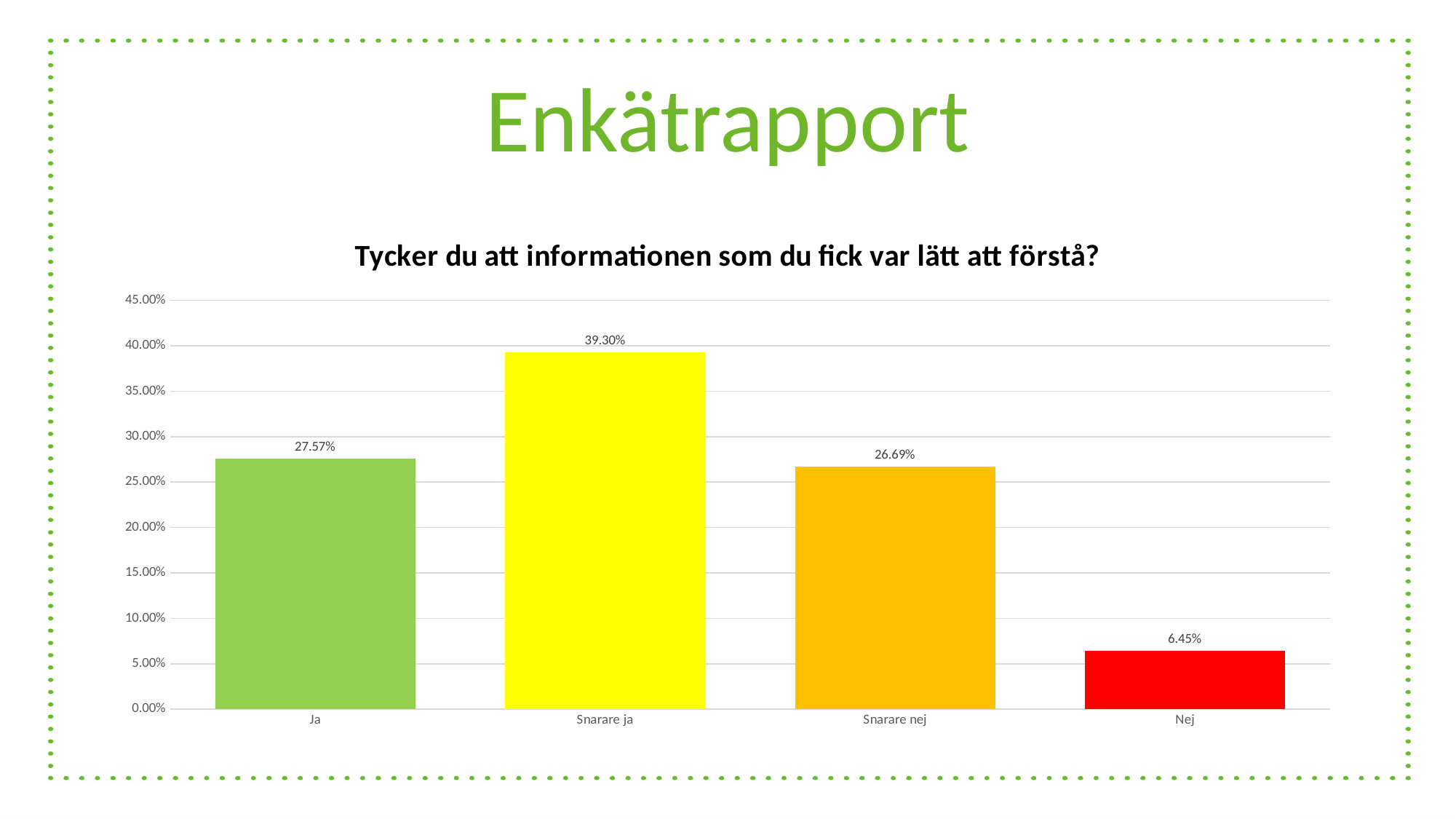
Which category has the lowest value? Nej Which category has the highest value? Snarare ja How many categories are shown on the x axis? 4 What is the value for "Snarare ja"? 39.30% What is the difference between the values for "Snarare nej" and "Nej"? 20.24% Is the value for "Snarare ja" greater or less than 35.00%? greater Which is larger, the value for "Ja" or the value for "Nej"? Ja What kind of chart is shown on the slide? Bar chart What is the value for "Snarare nej"? 26.69% What is the value for "Nej"? 6.45% What is the difference between the values for "Snarare ja" and "Ja"? 11.73% What is the value for "Ja"? 27.57%